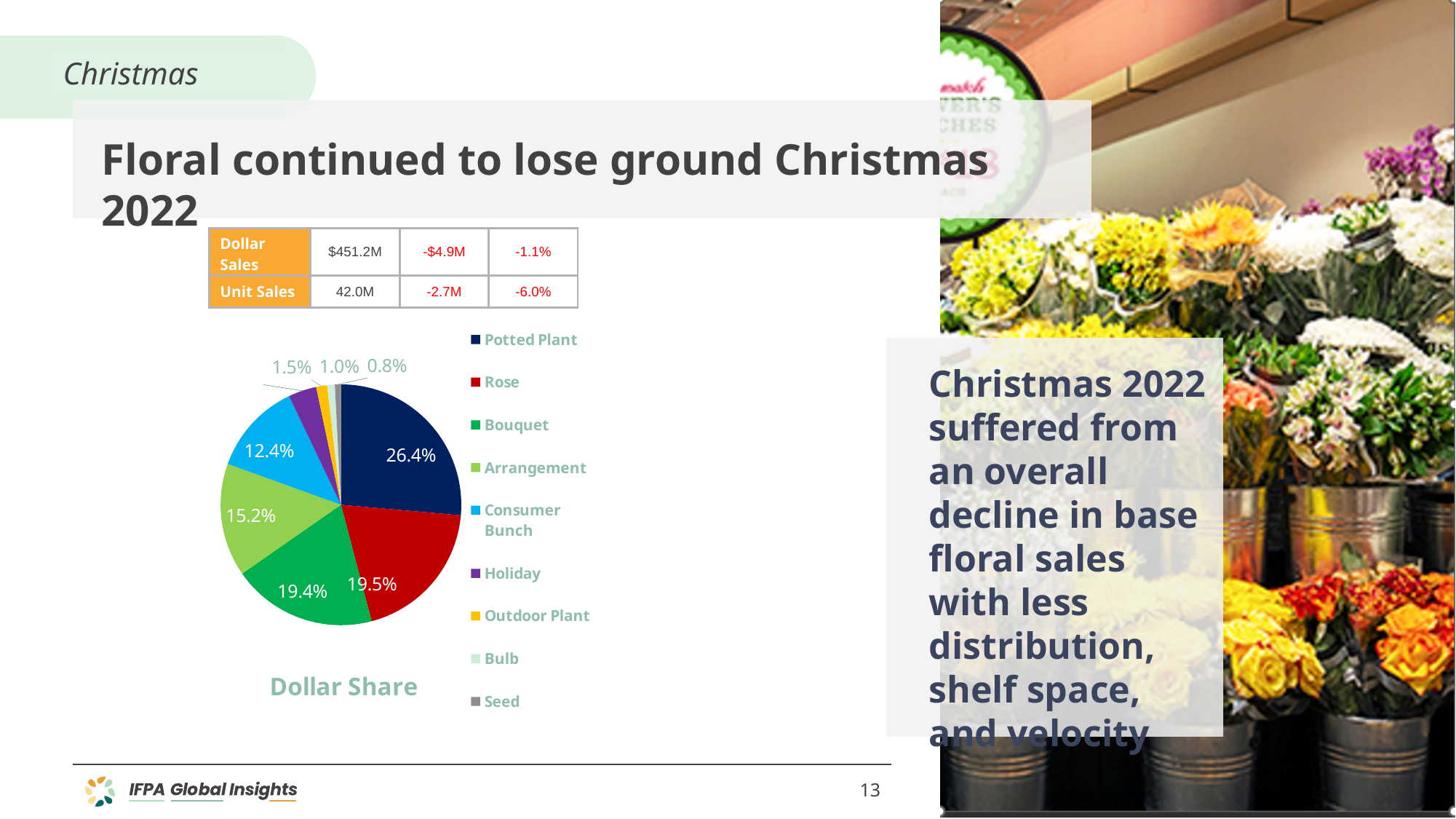
What kind of chart is shown on the slide? Pie chart What is the dollar share for Consumer Bunch in the pie chart? 12.4% What is the dollar share for Arrangement in the pie chart? 15.2% What is the dollar share for Bouquet in the pie chart? 19.4% What is the title of the pie chart? Dollar Share What is the dollar share for Potted Plant in the pie chart? 26.4% What is the dollar share for Rose in the pie chart? 19.5% How many categories does the pie chart legend list? 9 Which category has the largest slice of the pie chart? Potted Plant Which has a larger dollar share, Arrangement or Consumer Bunch? Arrangement How many percentage points larger is Potted Plant's share than Arrangement's share? 11.2 percentage points How many percentage points larger is Potted Plant's share than Consumer Bunch's share? 14.0 percentage points